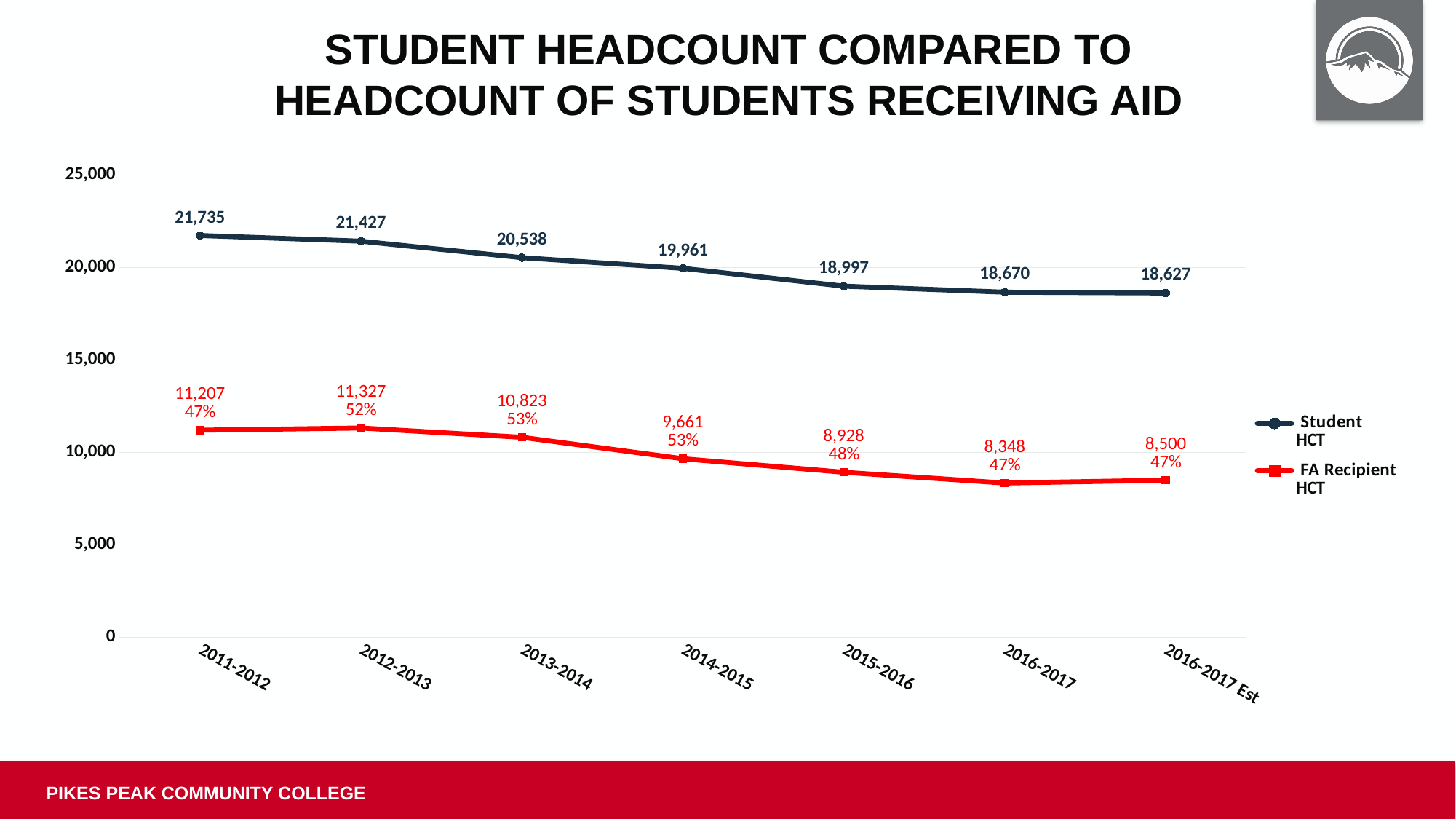
What is the difference between Student HCT and FA Recipient HCT in 2016-2017? 10,322 Is the Student HCT for 2013-2014 greater or less than 20,000? greater Does the Student HCT rise or fall from 2011-2012 to 2016-2017 Est? Fall What kind of chart is shown on the slide? Line chart What percentage is shown for FA Recipient HCT in 2013-2014? 53% What is the Student HCT value for 2011-2012? 21,735 What is the FA Recipient HCT value for 2014-2015? 9,661 How many year categories are shown on the x axis? 7 Which year has the highest FA Recipient HCT? 2012-2013 How many series does the legend list? 2 Which year has the lowest Student HCT? 2016-2017 Est Which is larger, the FA Recipient HCT in 2011-2012 or in 2015-2016? 2011-2012